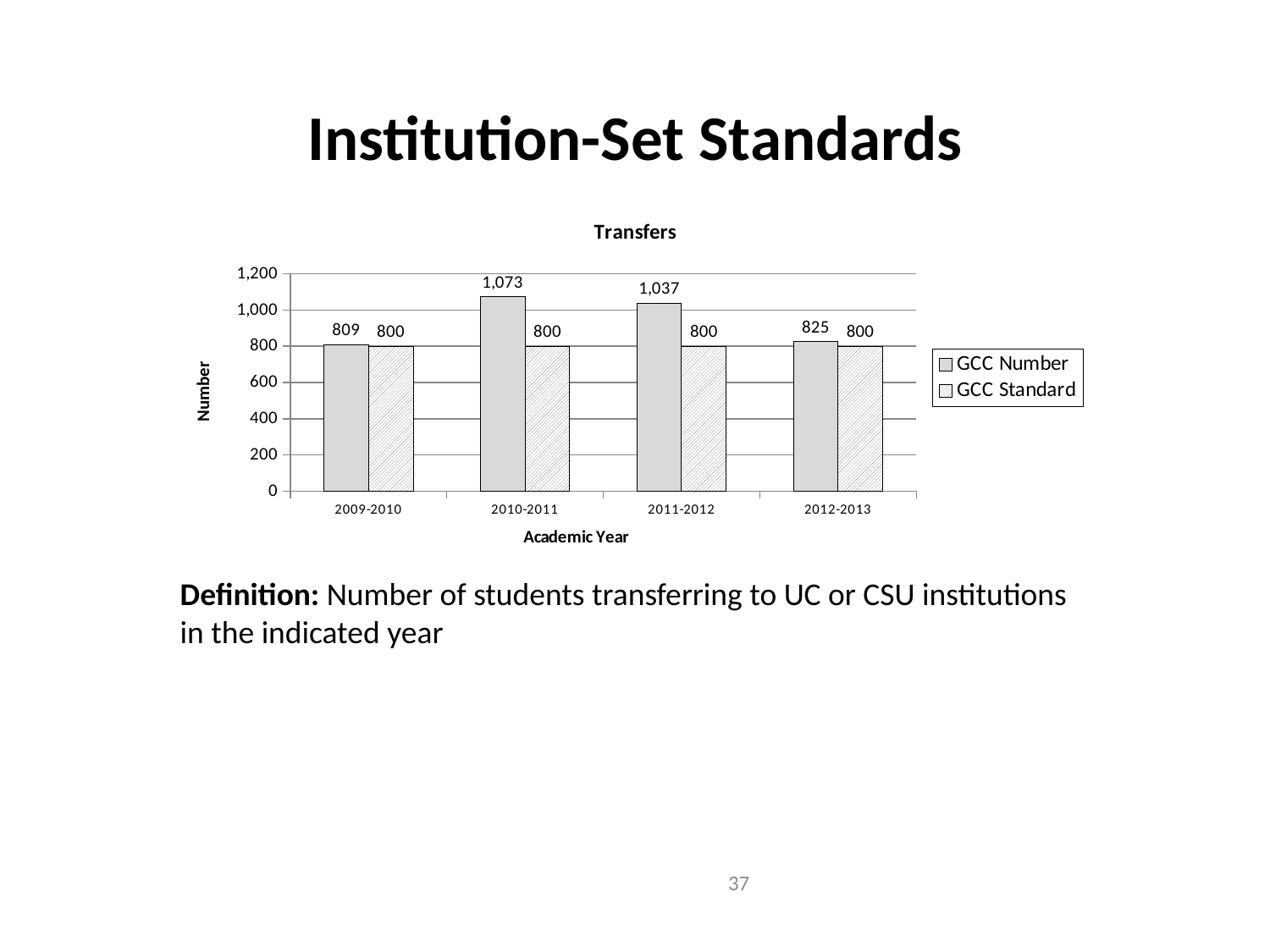
What kind of chart is shown on the slide? bar chart Which academic year has the highest GCC Number of transfers? 2010-2011 What is the GCC Number of transfers for 2009-2010? 809 What is the GCC Standard value for 2012-2013? 800 Which academic year has the lowest GCC Number of transfers? 2009-2010 Which is larger, the GCC Number for 2011-2012 or for 2012-2013? 2011-2012 Is the GCC Number for 2010-2011 greater or less than 1,000? greater How many series does the legend list? 2 What is the GCC Number of transfers for 2010-2011? 1,073 How many academic years are shown on the x axis? 4 How much higher is the GCC Number in 2010-2011 than in 2012-2013? 248 What is the difference between the GCC Number and the GCC Standard in 2011-2012? 237